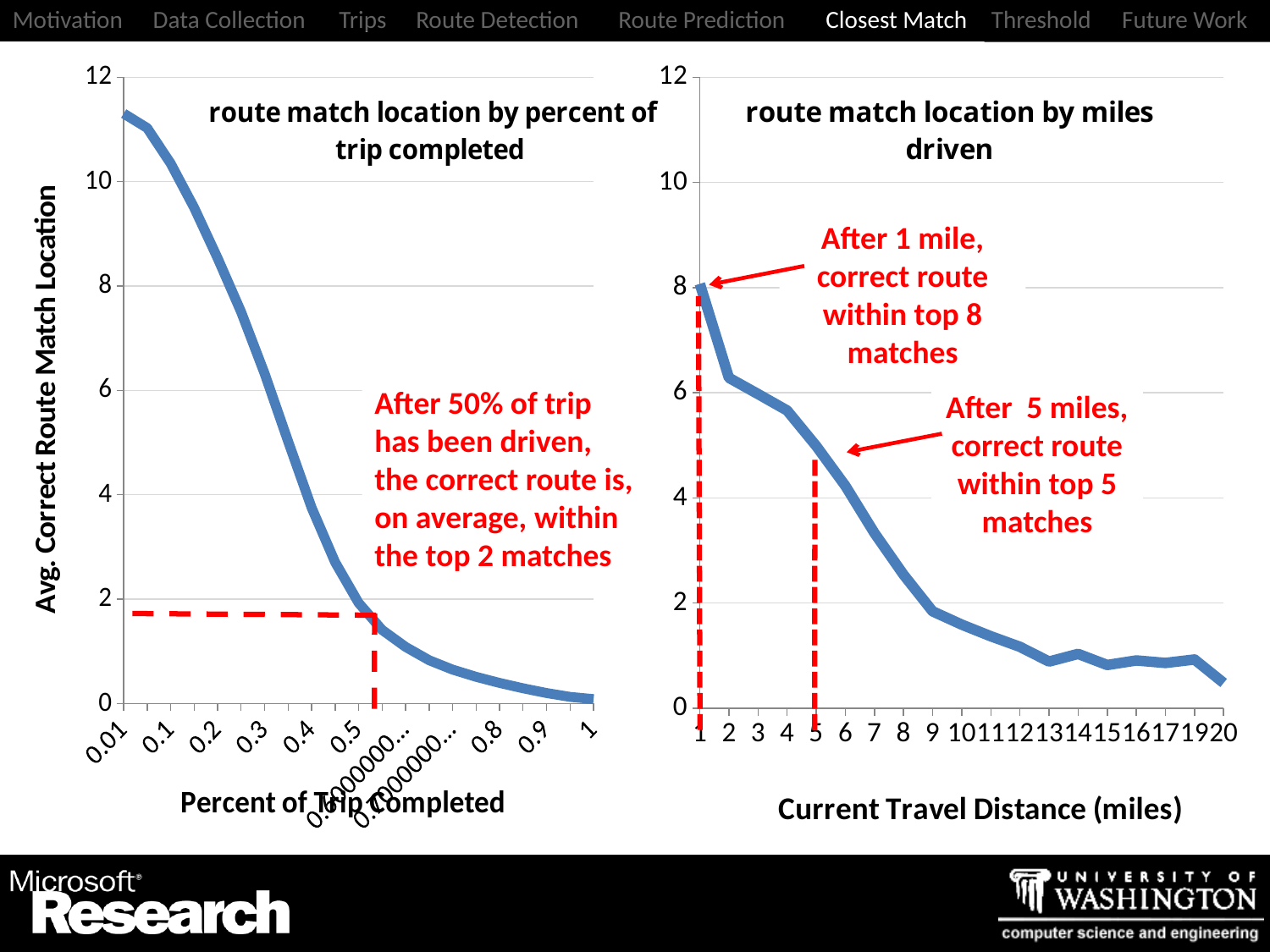
In the 'route match location by percent of trip completed' chart, is the value at 0.01 greater or less than 10? greater In the 'route match location by miles driven' chart, is the value at 5 miles greater or less than 4? greater How many travel distance values are labelled on the x axis of the 'route match location by miles driven' chart? 19 What is the y-axis label shared by the charts on the slide? Avg. Correct Route Match Location In the 'route match location by percent of trip completed' chart, is the value at 0.8 greater or less than 2? less What kind of chart is the 'route match location by miles driven' chart? line chart In the 'route match location by miles driven' chart, do the values rise or fall as the travel distance increases? fall In the 'route match location by miles driven' chart, which travel distance has the highest value, 1 mile or 20 miles? 1 mile What is the x-axis label of the 'route match location by miles driven' chart? Current Travel Distance (miles) In the 'route match location by percent of trip completed' chart, do the values rise or fall as the percent of trip completed increases? fall